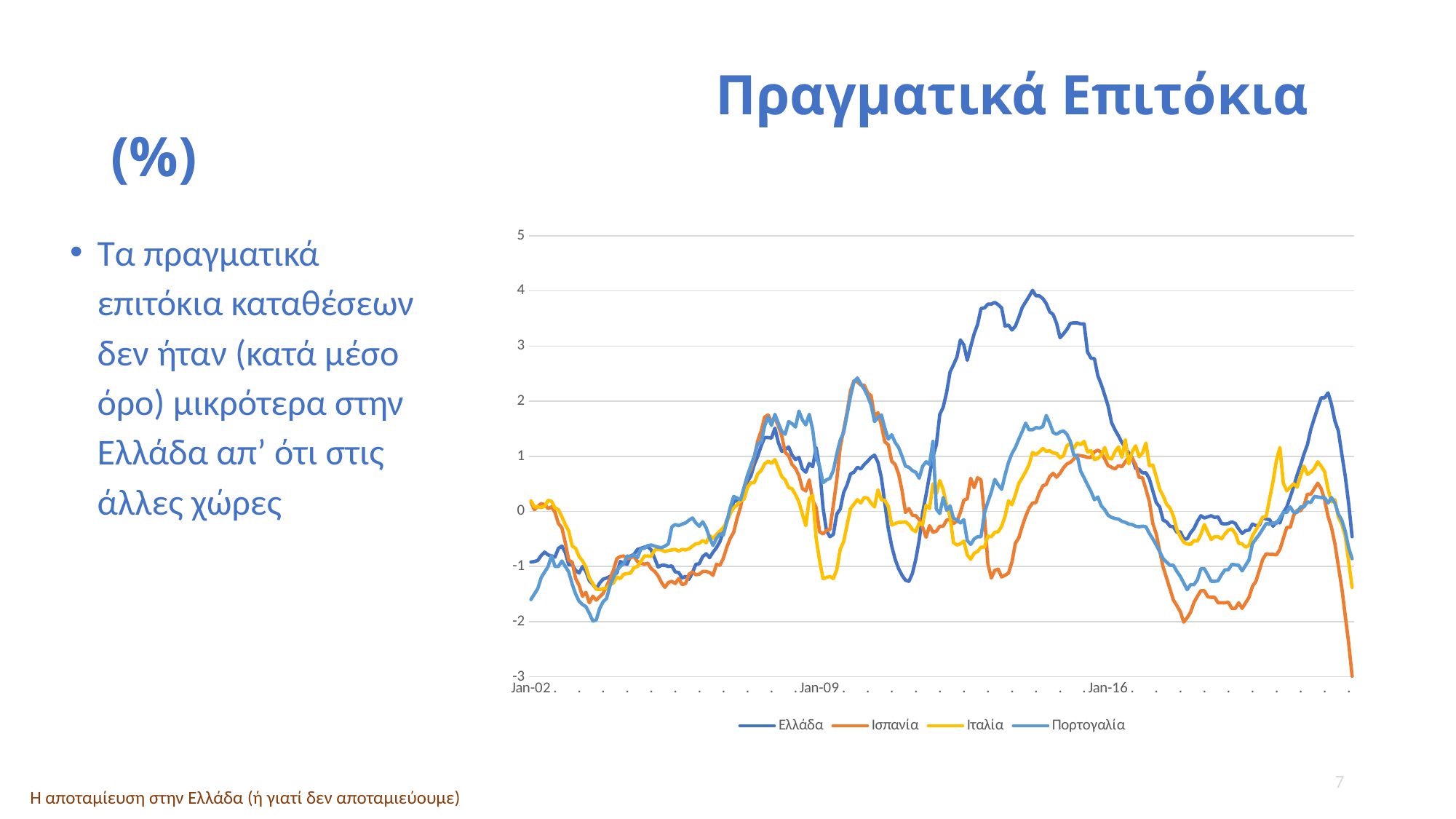
What is the title of the chart? Πραγματικά Επιτόκια (%) Is the lowest value for Ισπανία at the right end of the chart greater or less than -2? less Is the peak value for Ελλάδα greater or less than 3? greater What kind of chart is shown on the slide? line chart Is the peak value for Ιταλία greater or less than 2? less What is the highest value shown on the vertical axis? 5 Which series are listed in the legend? Ελλάδα, Ισπανία, Ιταλία, Πορτογαλία Which series reaches the highest value on the chart? Ελλάδα Which series reaches the lowest value on the chart? Ισπανία How many series does the legend list? 4